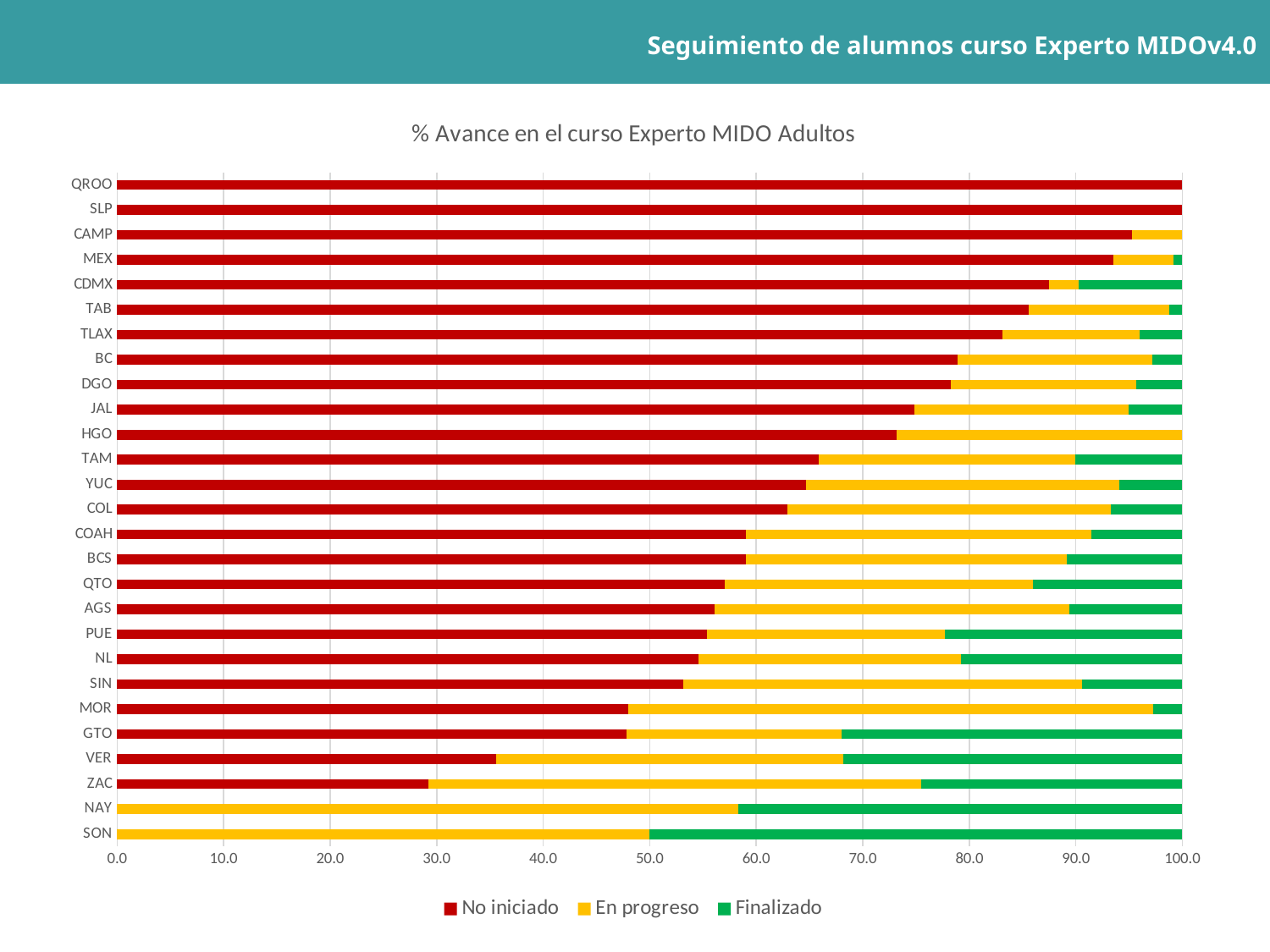
How many categories (states) are plotted on the chart? 27 How many series does the legend list? 3 Is the No iniciado value for HGO greater or less than 70? greater Is the No iniciado value for NL greater or less than 60? less Is the No iniciado value for VER greater or less than 40? less Which series is shown in green in the legend? Finalizado Which has the larger No iniciado value, GTO or VER? GTO Which category has the largest Finalizado segment? SON What is the title of the chart? % Avance en el curso Experto MIDO Adultos Going from QROO at the top to SON at the bottom, do the No iniciado values rise or fall? fall What kind of chart is shown on the slide? Stacked bar chart